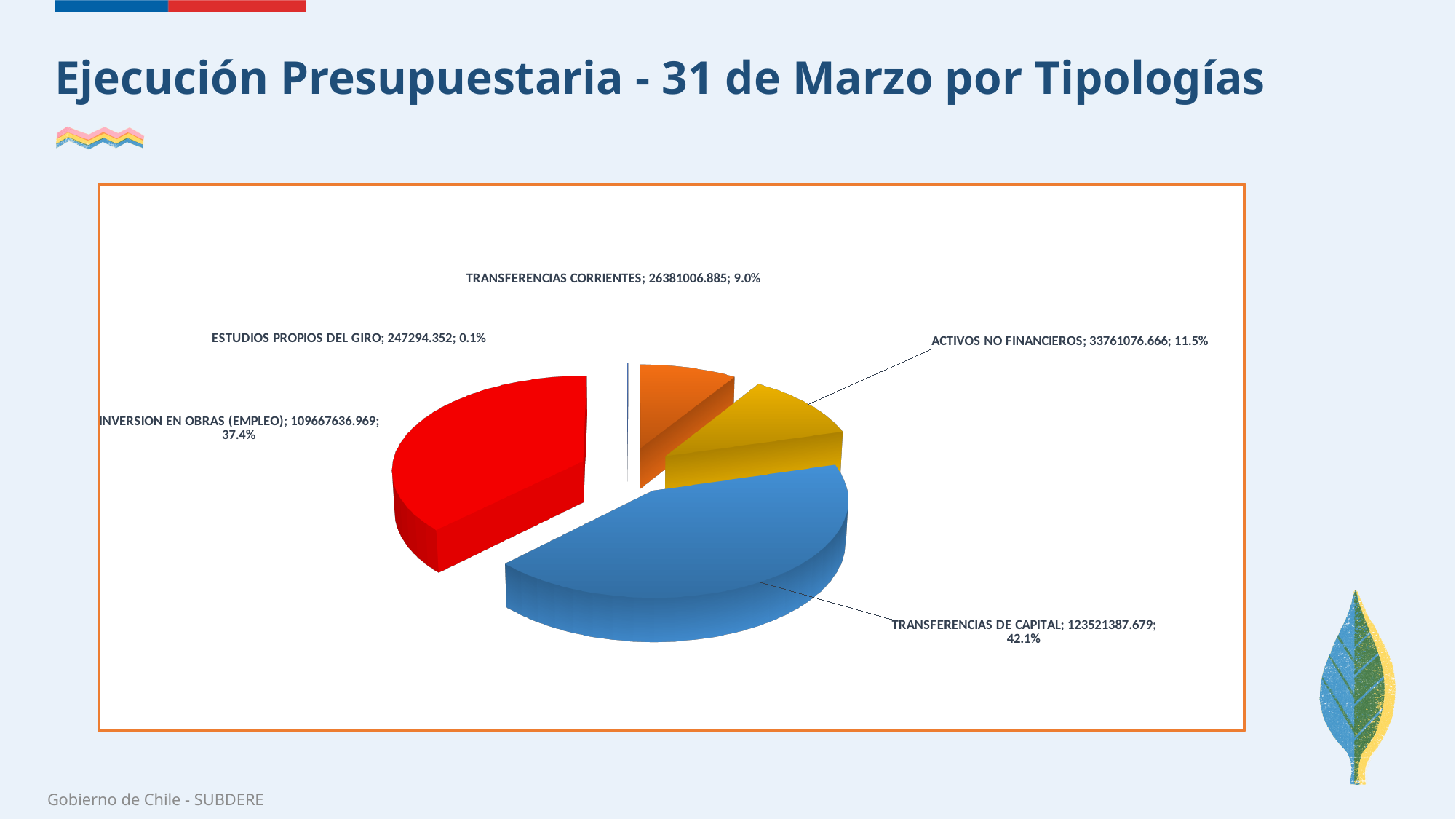
What is the value for ACTIVOS NO FINANCIEROS? 33761076.666 What is the difference in percentage points between the shares of TRANSFERENCIAS DE CAPITAL and INVERSION EN OBRAS (EMPLEO)? 4.7 Which category has the smallest share of the pie? ESTUDIOS PROPIOS DEL GIRO What is the value for TRANSFERENCIAS DE CAPITAL? 123521387.679 Which is larger, the share for ACTIVOS NO FINANCIEROS or the share for TRANSFERENCIAS CORRIENTES? ACTIVOS NO FINANCIEROS What percentage is shown for TRANSFERENCIAS CORRIENTES? 9.0% What share of the pie does INVERSION EN OBRAS (EMPLEO) represent? 37.4% What kind of chart is shown on the slide? pie chart Which category has the largest share of the pie? TRANSFERENCIAS DE CAPITAL What colour is the TRANSFERENCIAS DE CAPITAL slice? blue What is the value for ESTUDIOS PROPIOS DEL GIRO? 247294.352 How many slices does the pie chart have? 5